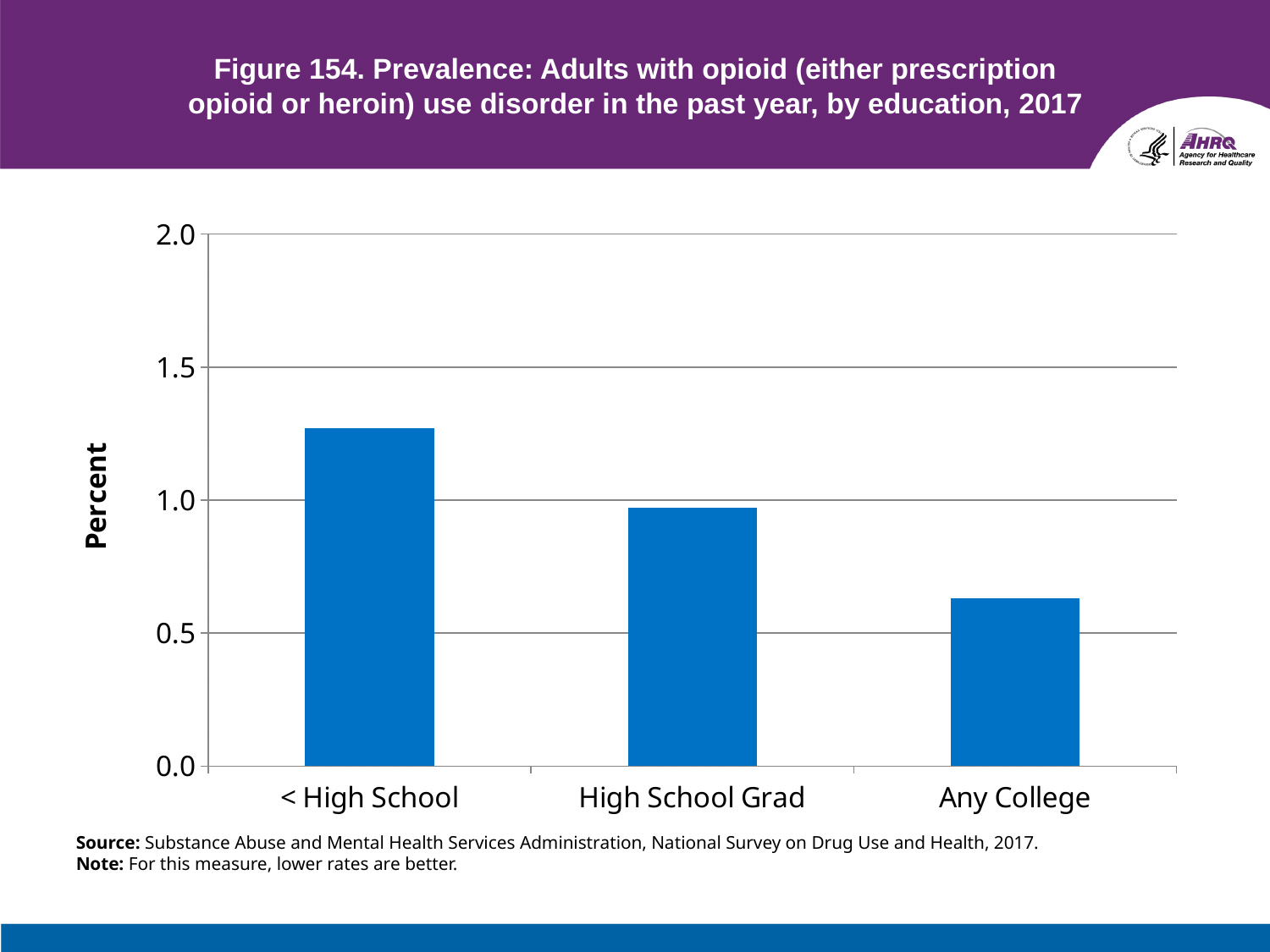
What is the label on the vertical axis of the chart? Percent What kind of chart is shown on the slide? Bar chart Is the value for Any College greater or less than 0.5? greater Is the value for < High School greater or less than 1.5? less Is the value for High School Grad greater or less than 0.5? greater Which education category has the highest prevalence of opioid use disorder? < High School Do the values rise or fall moving from < High School to Any College along the x axis? fall Which is larger, the value for < High School or the value for Any College? < High School Which education category has the lowest prevalence of opioid use disorder? Any College How many education categories are shown on the x axis? 3